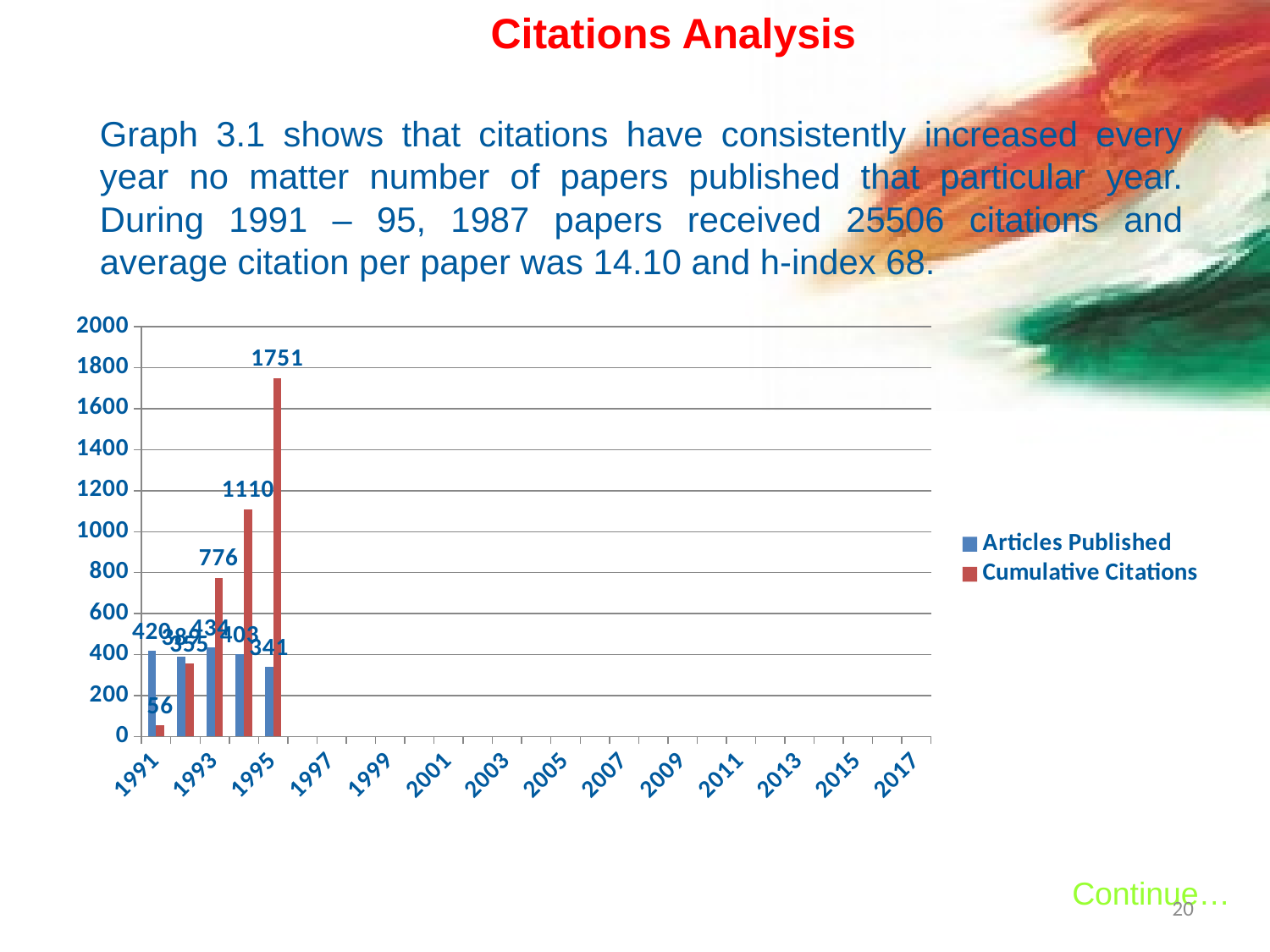
What is the value of Cumulative Citations for 1995? 1751 Which year has the highest Cumulative Citations value? 1995 Which year has the lowest Cumulative Citations value? 1991 What is the value of Cumulative Citations for 1993? 776 How many series does the chart legend list? 2 Do the Cumulative Citations values rise or fall from 1991 to 1995? rise In 1993, which is larger: Articles Published or Cumulative Citations? Cumulative Citations Is the value of Articles Published for 1992 greater or less than 200? greater What is the value of Cumulative Citations for 1991? 56 What kind of chart is shown on the slide? bar chart What is the difference between Cumulative Citations in 1995 and in 1994? 641 What is the value of Articles Published for 1995? 341